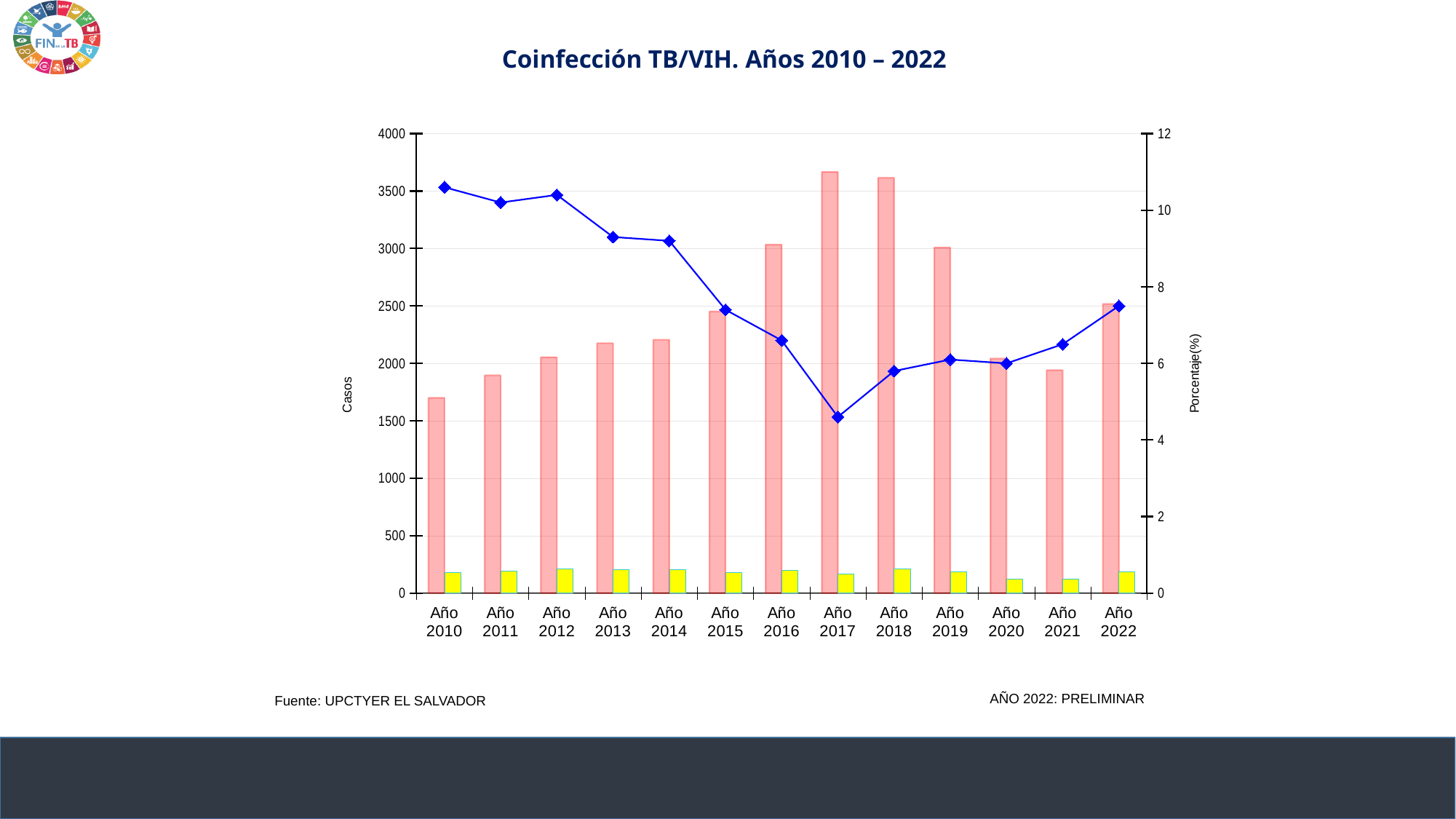
In which year is the pink bar the lowest? Año 2010 What kind of chart is shown on the slide? Combined bar and line chart What is the label of the right-hand vertical axis? Porcentaje(%) What is the title of the chart? Coinfección TB/VIH. Años 2010 – 2022 Which year has the taller pink bar, Año 2015 or Año 2016? Año 2016 Is the pink bar for Año 2017 greater or less than 3500 on the left axis? greater In which year does the blue line reach its highest point? Año 2010 In which year does the blue line reach its lowest point? Año 2017 Is the blue line value for Año 2017 greater or less than 6 on the right axis? less Does the blue line rise or fall between Año 2010 and Año 2017? fall How many years are shown on the x axis of the chart? 13 Is the pink bar for Año 2010 greater or less than 2000 on the left axis? less